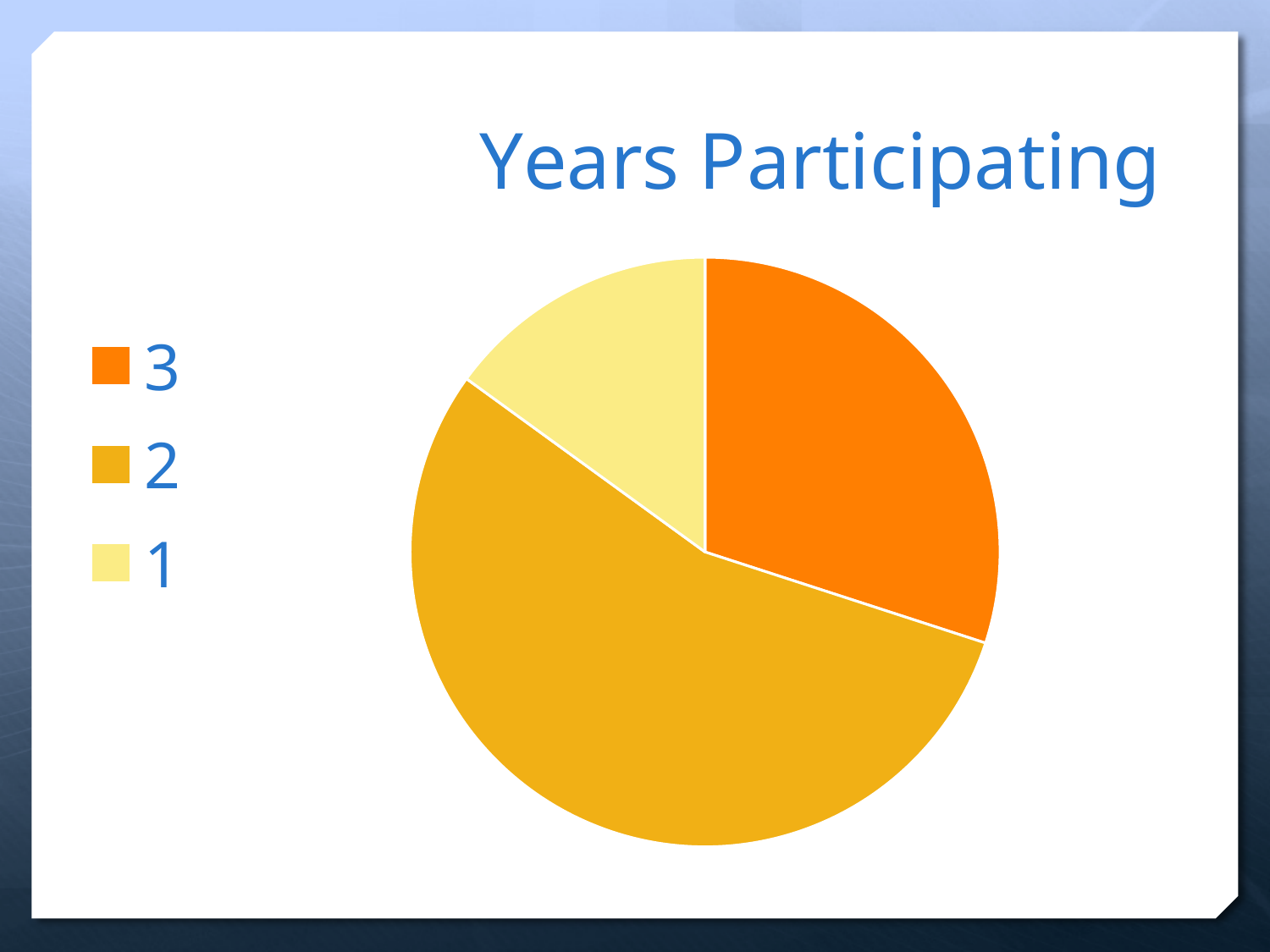
Which categories are listed in the legend? 3, 2, 1 What colour is the slice for category 1? light yellow Which slice is larger, the one for 2 or the one for 3? 2 What is the title of the chart? Years Participating Which category has the largest slice of the pie? 2 Which category has the smallest slice of the pie? 1 Which slice is larger, the one for 3 or the one for 1? 3 What kind of chart is shown on the slide? pie chart How many slices does the pie chart have? 3